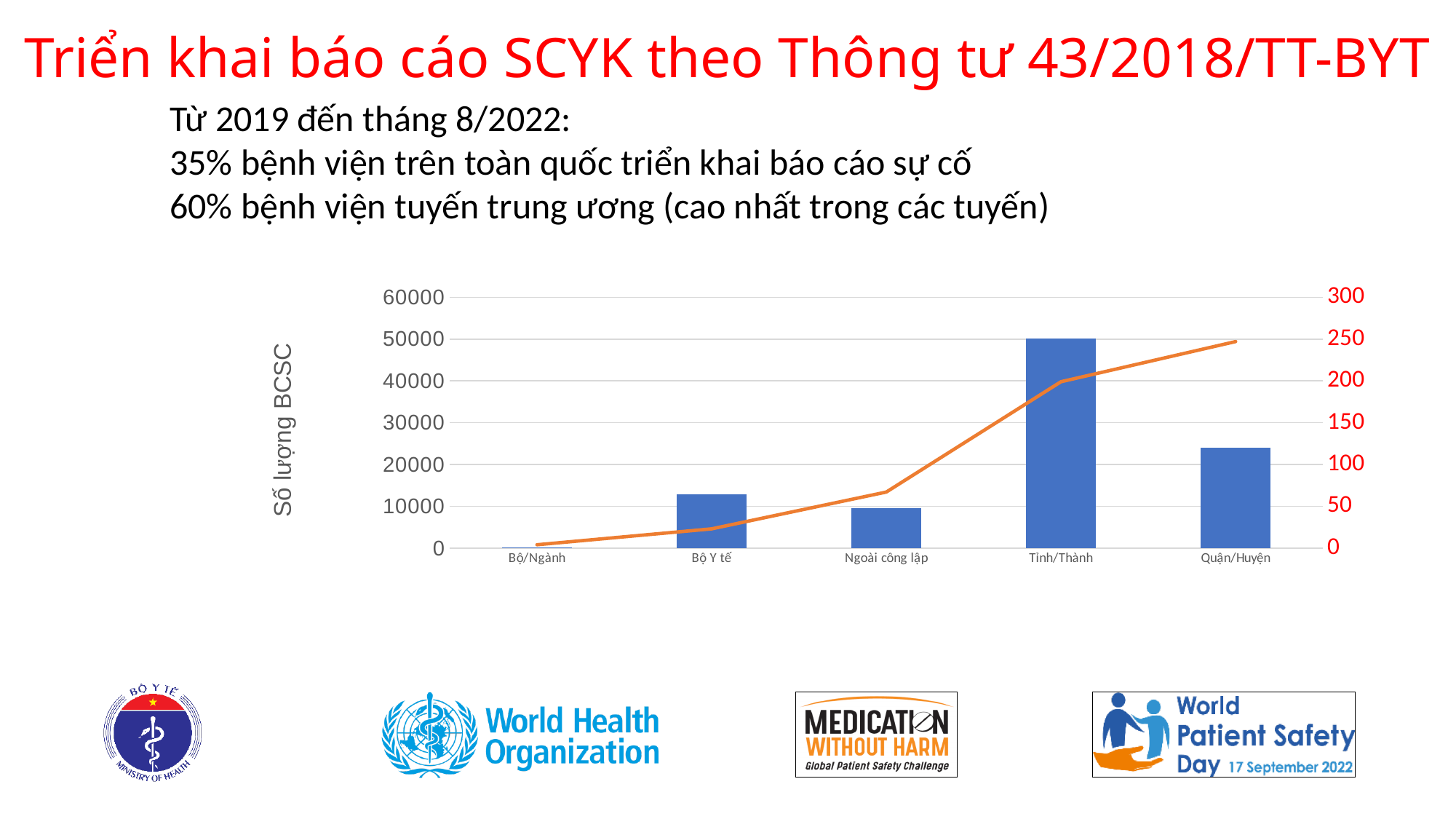
Is the bar value for Tỉnh/Thành greater or less than 40000? greater Which bar is taller, Bộ Y tế or Ngoài công lập? Bộ Y tế Which category has the tallest bar? Tỉnh/Thành Which category has the shortest bar? Bộ/Ngành Does the orange line rise or fall from Bộ/Ngành to Quận/Huyện? rises How many categories are shown on the x axis? 5 On the right-hand axis, is the line value for Ngoài công lập greater or less than 100? less Which bar is taller, Quận/Huyện or Bộ Y tế? Quận/Huyện What is the title of the left vertical axis? Số lượng BCSC On the right-hand axis, is the line value for Quận/Huyện greater or less than 200? greater